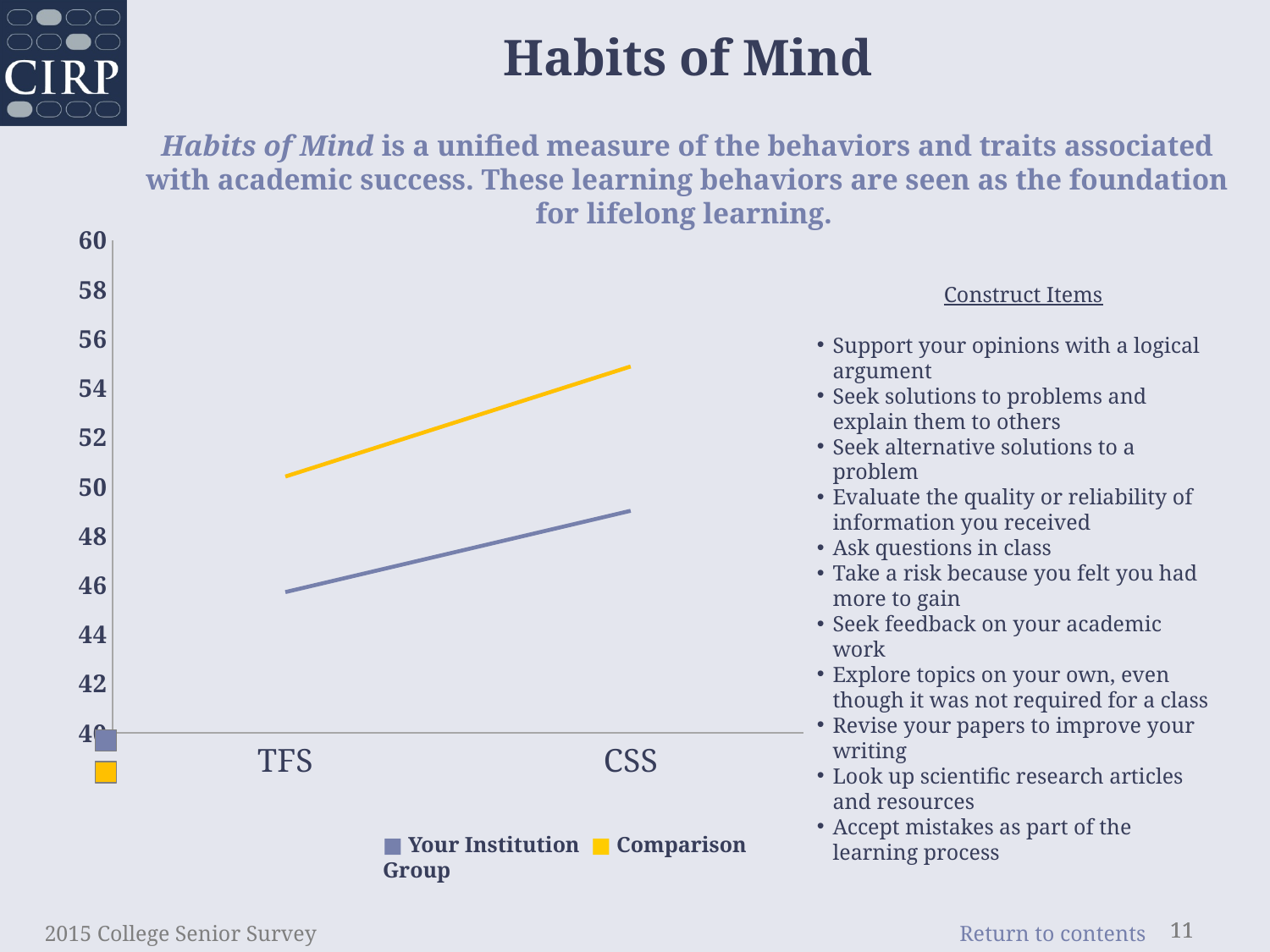
What kind of chart is shown on the slide? line chart Do the values for Your Institution rise or fall from TFS to CSS? rise Is the value for Comparison Group at TFS greater or less than 48? greater How many categories are shown on the x axis of the chart? 2 Is the value for Your Institution at CSS greater or less than 50? less Do the values for Comparison Group rise or fall from TFS to CSS? rise Is the value for Your Institution at CSS greater or less than 48? greater How many series does the chart's legend list? 2 At CSS, which series has the higher value, Your Institution or Comparison Group? Comparison Group At TFS, which series has the higher value, Your Institution or Comparison Group? Comparison Group Which series is plotted in yellow? Comparison Group